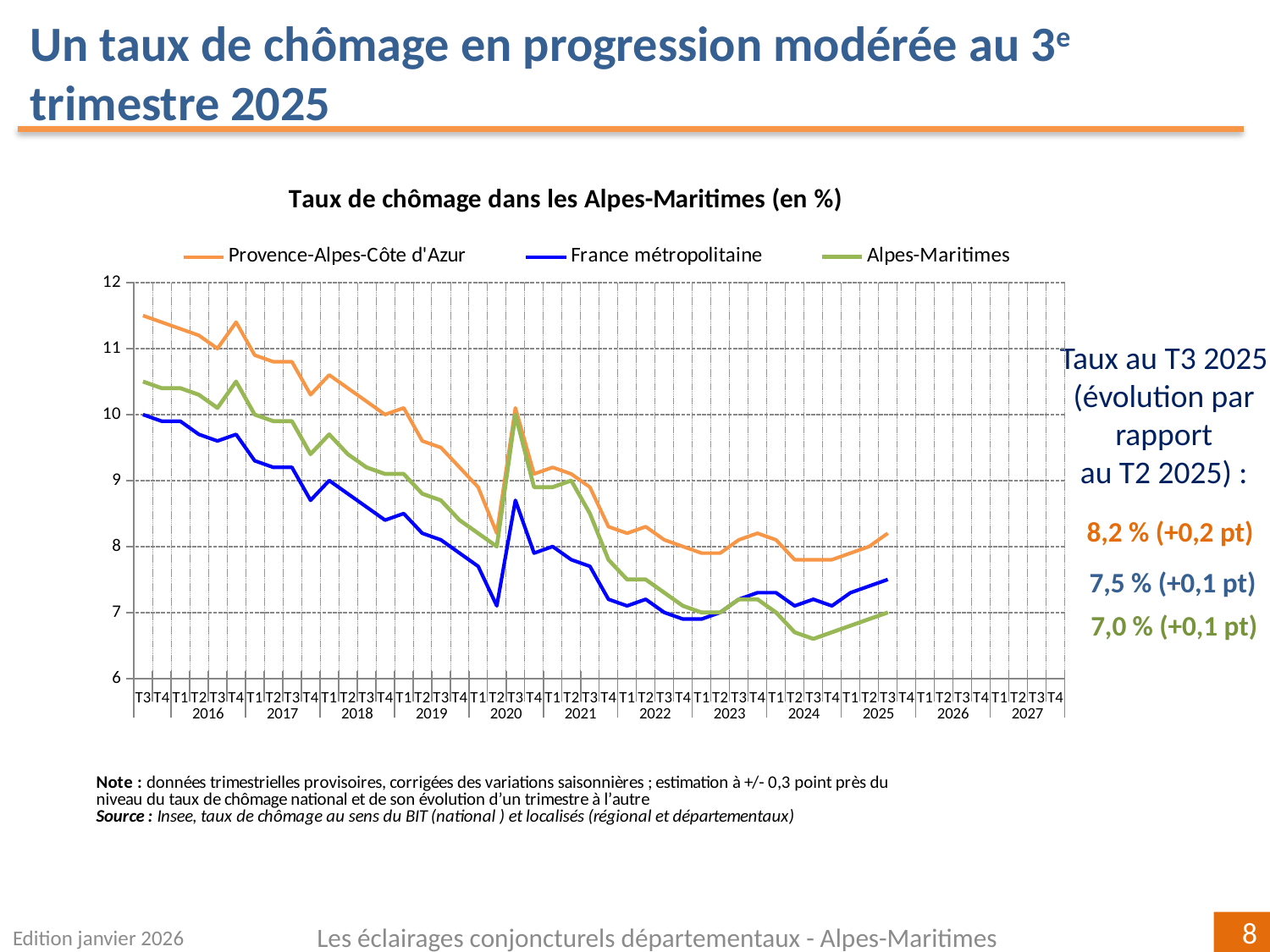
What is the title of the chart? Taux de chômage dans les Alpes-Maritimes (en %) What is the unemployment rate for Alpes-Maritimes at T3 2025? 7,0 % Overall, from 2016 to 2025, does the Alpes-Maritimes unemployment rate rise or fall? fall What is the unemployment rate for France métropolitaine at T3 2025? 7,5 % Is the value for Alpes-Maritimes at T3 2024 greater or less than 7? less Which series has the lowest value at T3 2025? Alpes-Maritimes By how much did the Provence-Alpes-Côte d'Azur rate change between T2 2025 and T3 2025? +0,2 pt How many series does the legend list? 3 At T3 2025, which is higher: the rate for Provence-Alpes-Côte d'Azur or for France métropolitaine? Provence-Alpes-Côte d'Azur What is the unemployment rate for Provence-Alpes-Côte d'Azur at T3 2025? 8,2 % What is the difference between the Provence-Alpes-Côte d'Azur rate and the Alpes-Maritimes rate at T3 2025? 1,2 points What kind of chart is shown on the slide? line chart